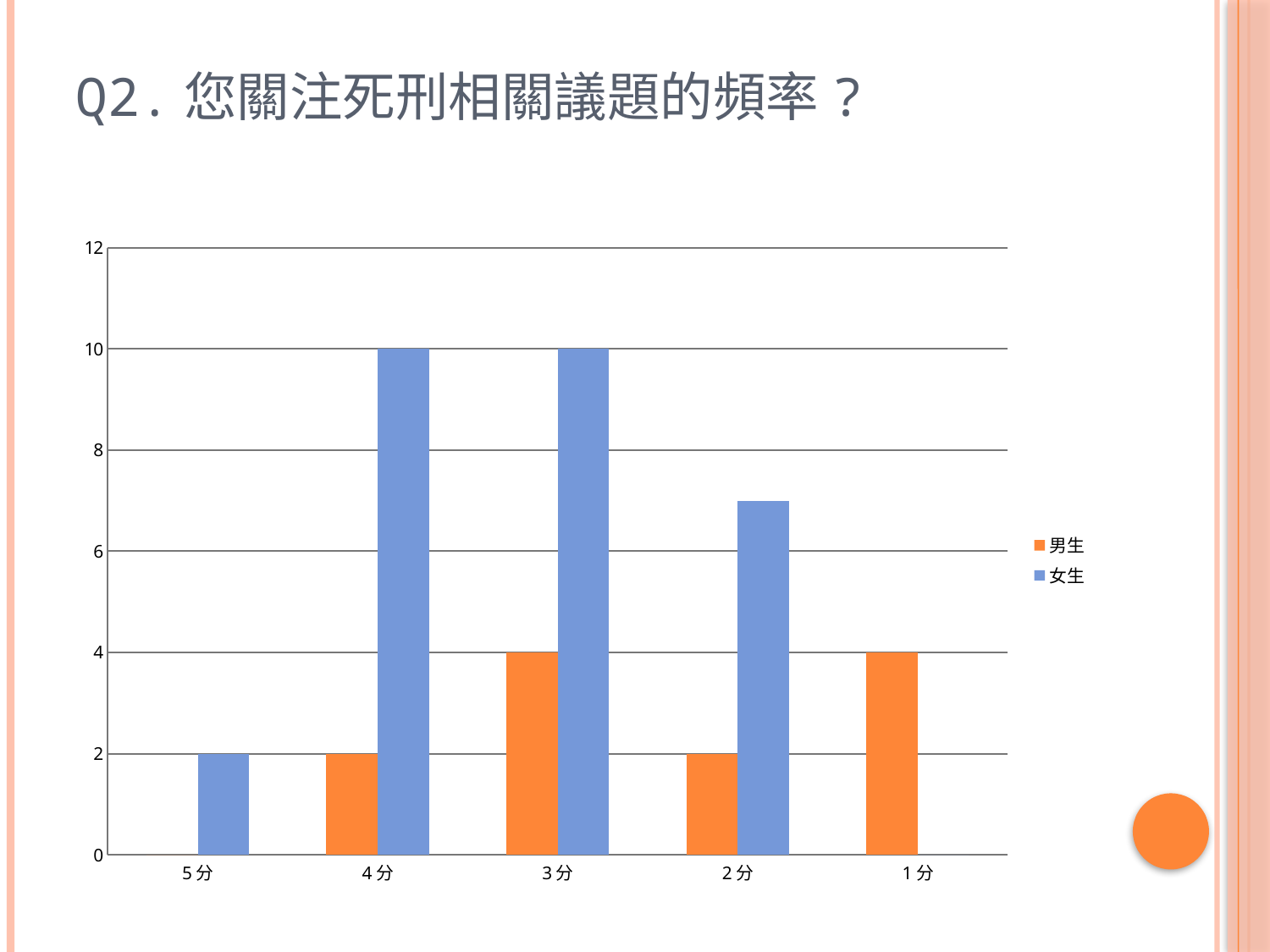
What is the value for 女生 at 4 分? 10 How many series does the legend list? 2 What kind of chart is shown on the slide? bar chart Which series is shown in orange in the legend? 男生 What is the value for 女生 at 5 分? 2 How many categories are shown on the x axis? 5 What is the value for 男生 at 1 分? 4 What is the value for 男生 at 3 分? 4 Which category has the lowest value for 女生 among those with a visible 女生 bar? 5 分 Is the value for 女生 at 2 分 greater or less than 6? greater What is the difference between the 女生 value and the 男生 value at 4 分? 8 Which is larger at 3 分, the value for 男生 or the value for 女生? 女生